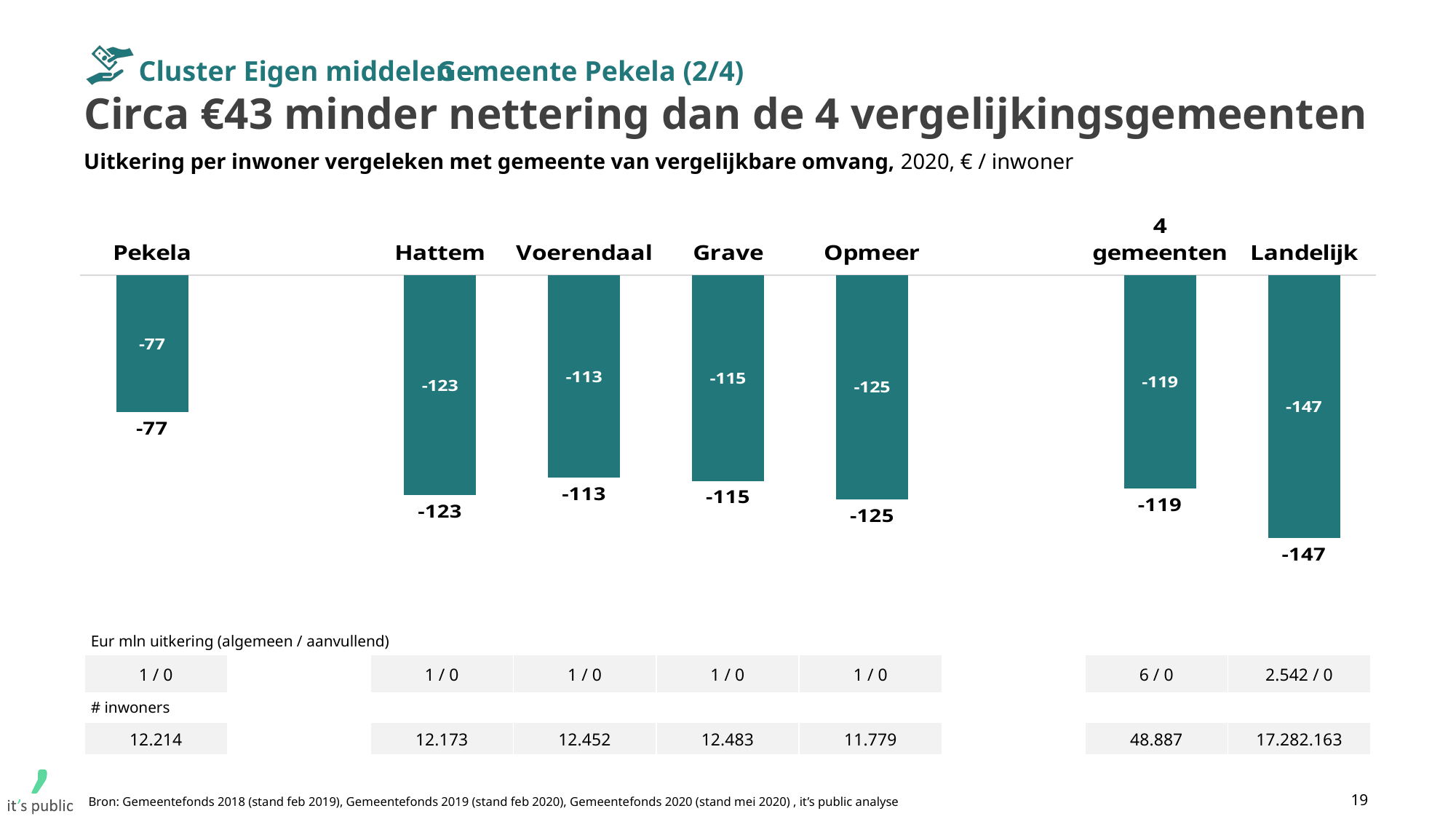
How many bars are shown in the chart? 7 What type of chart is shown on the slide? Bar chart What is the value for Hattem? -123 Which category has the highest (least negative) value? Pekela Which category has the lowest (most negative) value? Landelijk Which has the more negative value, Voerendaal or Grave? Grave What is the value for 4 gemeenten? -119 What is the difference between the values for Landelijk and Pekela? 70 What is the value for Pekela? -77 What is the difference between the values for Pekela and 4 gemeenten? 42 What is the value for Opmeer? -125 What is the value for Landelijk? -147